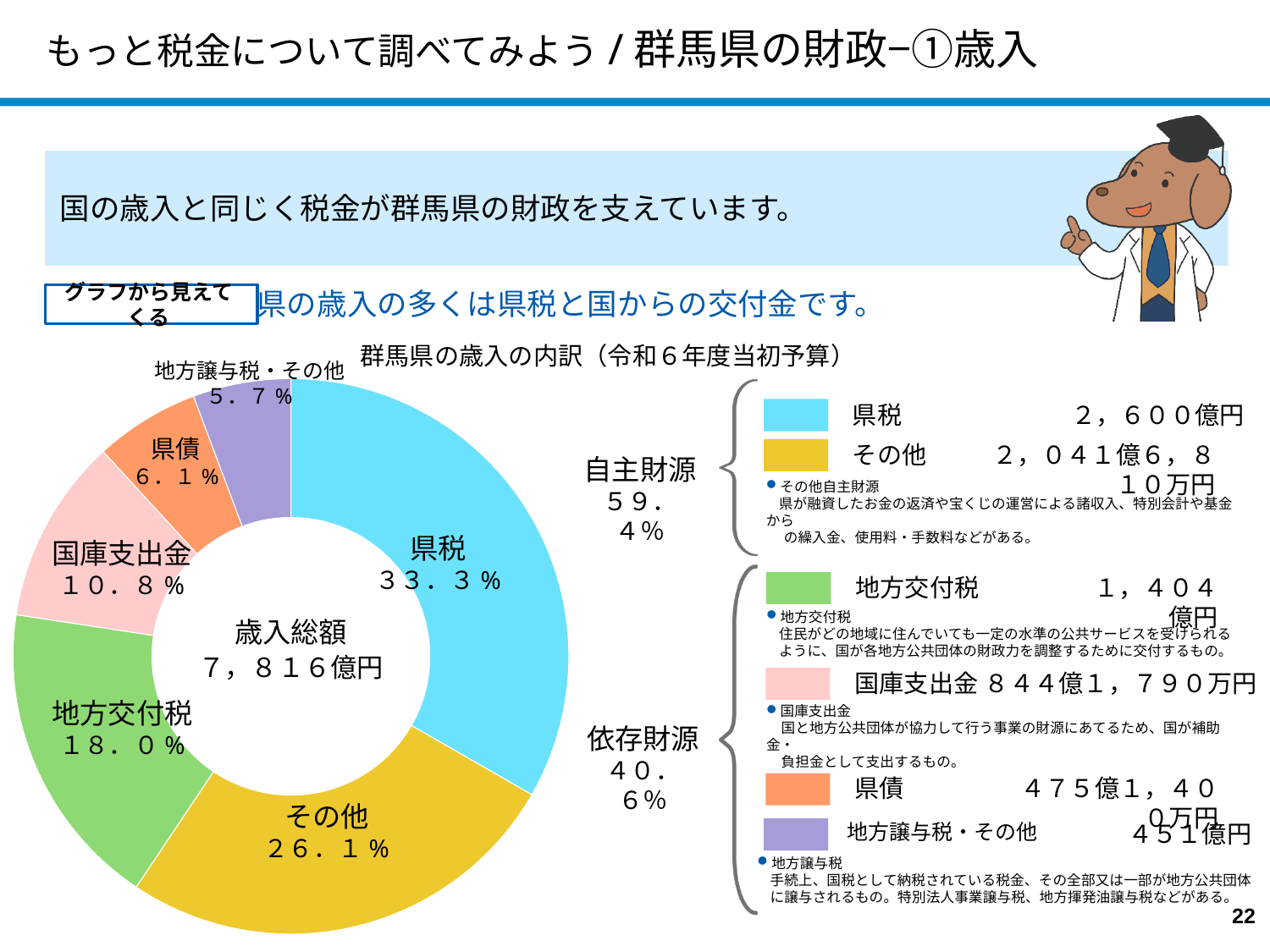
「群馬県の歳入の内訳」のグラフで、国庫支出金の割合は何％ですか？ 10.8% 「群馬県の歳入の内訳」のグラフで、県税の割合は何％ですか？ 33.3% 「群馬県の歳入の内訳」のグラフで、県税はどの色で示されていますか？ 水色 「群馬県の歳入の内訳」のグラフで、県税とその他の割合の差は何ポイントですか？ 7.2ポイント 「群馬県の歳入の内訳」のグラフはどの種類のグラフですか？ 円グラフ（ドーナツグラフ） 「群馬県の歳入の内訳」のグラフには、いくつの項目がありますか？ 6 「群馬県の歳入の内訳」のグラフで、地方交付税の割合は何％ですか？ 18.0% 「群馬県の歳入の内訳」のグラフで、最も割合が小さい項目はどれですか？ 地方譲与税・その他 「群馬県の歳入の内訳」のグラフの中央に示されている歳入総額はいくらですか？ 7,816億円 「群馬県の歳入の内訳」の凡例で、地方交付税の金額はいくらですか？ 1,404億円 「群馬県の歳入の内訳」のグラフで、最も割合が大きい項目はどれですか？ 県税 「群馬県の歳入の内訳」のグラフで、県債と国庫支出金ではどちらの割合が大きいですか？ 国庫支出金